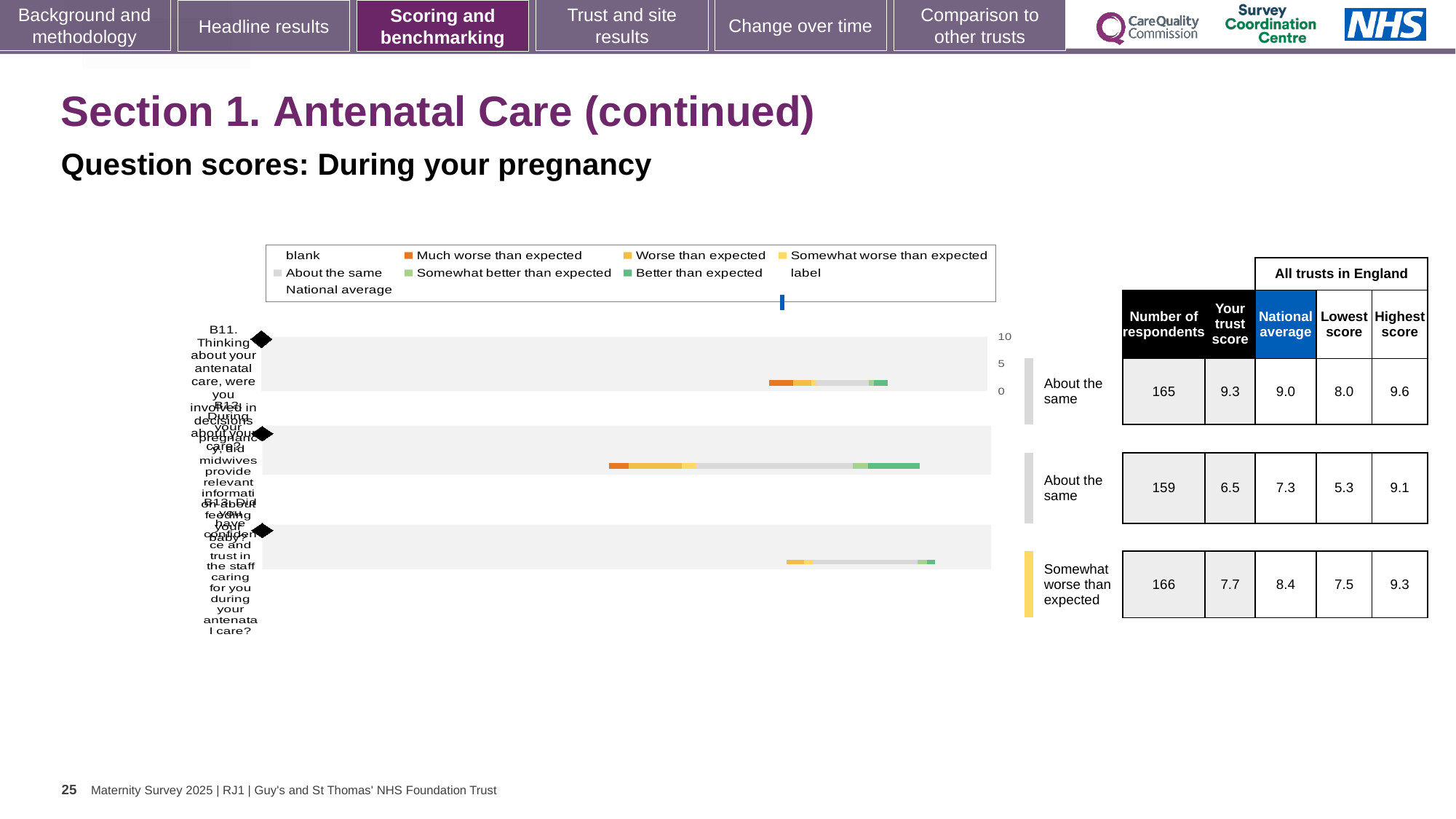
How many question bars (B11, B12, B13) are plotted in the chart? 3 In the table beside the chart, what is the 'Your trust score' for question B12? 6.5 What colour represents 'Better than expected' in the chart legend? Green Which question has the highest 'Your trust score' in the table beside the chart? B11 What colour represents 'Much worse than expected' in the chart legend? Orange By how much does the trust score for B11 (9.3) exceed the national average (9.0)? 0.3 Which question has the lowest 'Your trust score' in the table beside the chart? B12 How many entries does the chart legend list? 9 What kind of chart is shown on the slide? Bar chart In the table beside the chart, what is the national average for question B13? 8.4 In the table beside the chart, how many respondents are listed for question B11? 165 For question B13, which is larger: the trust score or the national average? National average